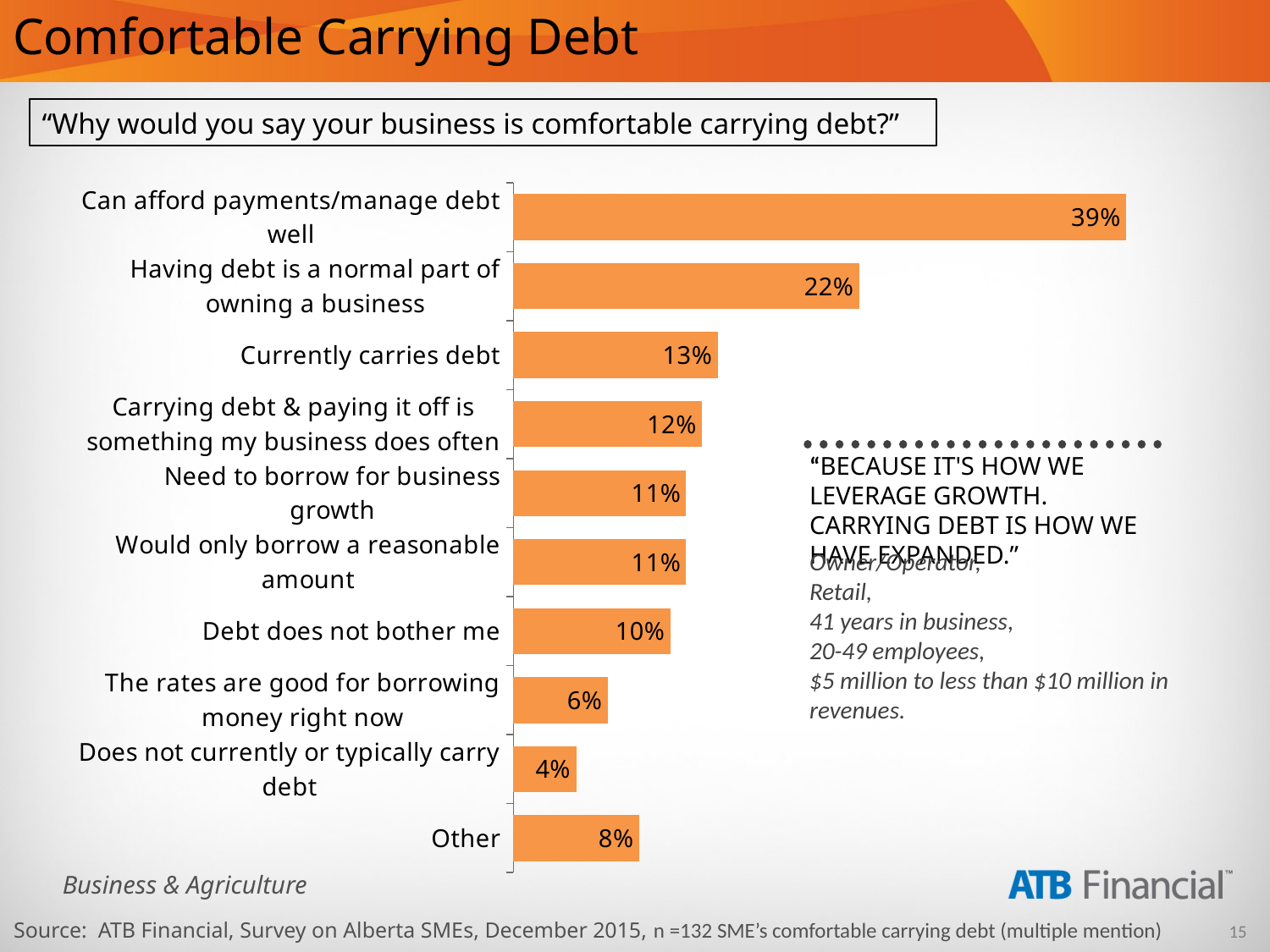
What is the difference between "Can afford payments/manage debt well" and "Having debt is a normal part of owning a business"? 17% How many categories are shown in the chart? 10 What survey question is the chart based on? Why would you say your business is comfortable carrying debt? Which is larger: "Debt does not bother me" or "Other"? Debt does not bother me What is the value for "The rates are good for borrowing money right now"? 6% What percentage is shown for "Currently carries debt"? 13% What is the value for "Having debt is a normal part of owning a business"? 22% What is the difference between "Currently carries debt" and "Does not currently or typically carry debt"? 9% What percentage of respondents said they can afford payments/manage debt well? 39% Which category has the lowest value? Does not currently or typically carry debt What kind of chart is shown on the slide? Bar chart Which category has the highest value? Can afford payments/manage debt well